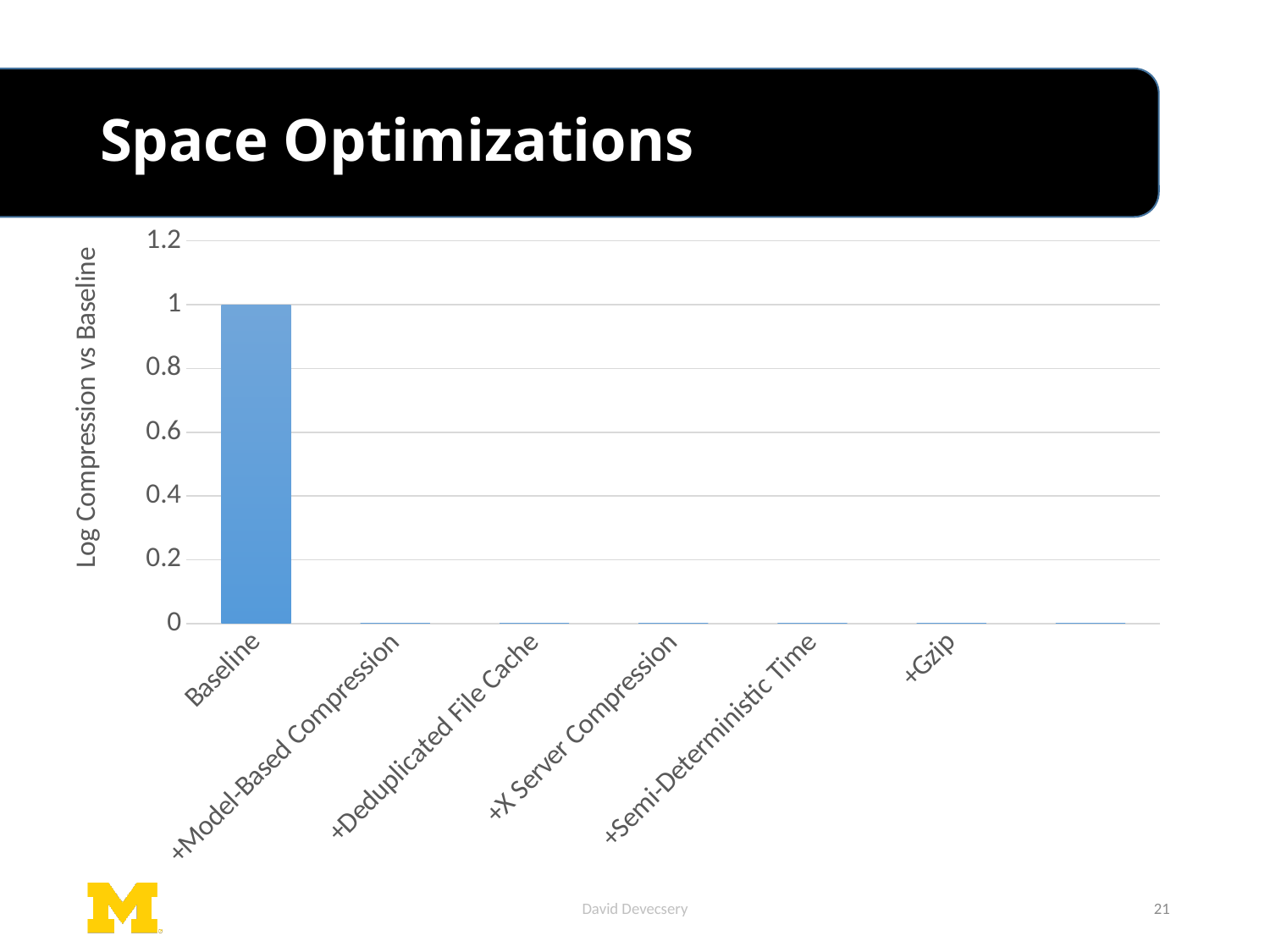
What is the highest tick value shown on the y axis? 1.2 What is the value for Baseline? 1 What is the label on the y axis? Log Compression vs Baseline Is the value for +Deduplicated File Cache greater or less than 0.2? less Is the value for Baseline greater or less than 0.8? greater Which is larger, the value for Baseline or the value for +X Server Compression? Baseline Is the value for +Gzip greater or less than 0.2? less How many categories are plotted along the x axis? 6 Which is larger, the value for +Semi-Deterministic Time or the value for Baseline? Baseline What kind of chart is shown on the slide? bar chart Which category has the highest value? Baseline